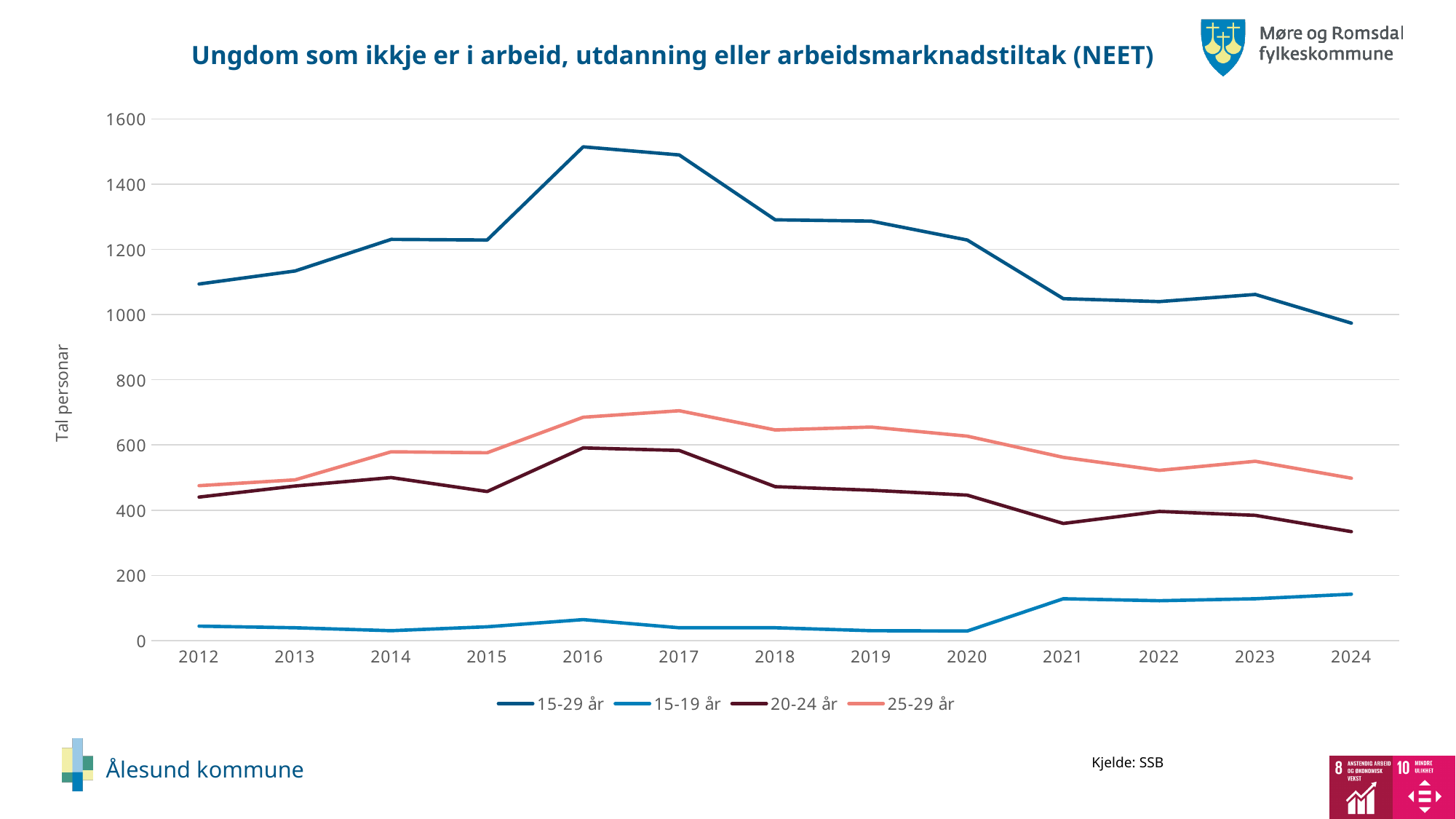
Is the value for 25-29 år in 2017 greater or less than 600? greater In which year is the value for the 15-29 år series lowest? 2024 In which year is the value for the 20-24 år series lowest? 2024 What is the label on the y axis? Tal personar How many series does the legend list? 4 Is the value for 15-19 år in 2021 greater or less than 200? less What kind of chart is shown on the slide? line chart How many years are plotted along the x axis? 13 Is the value for 15-29 år in 2024 greater or less than 1000? less In 2016, which series has the larger value: 25-29 år or 20-24 år? 25-29 år Does the 15-29 år series rise or fall from 2017 to 2024? fall